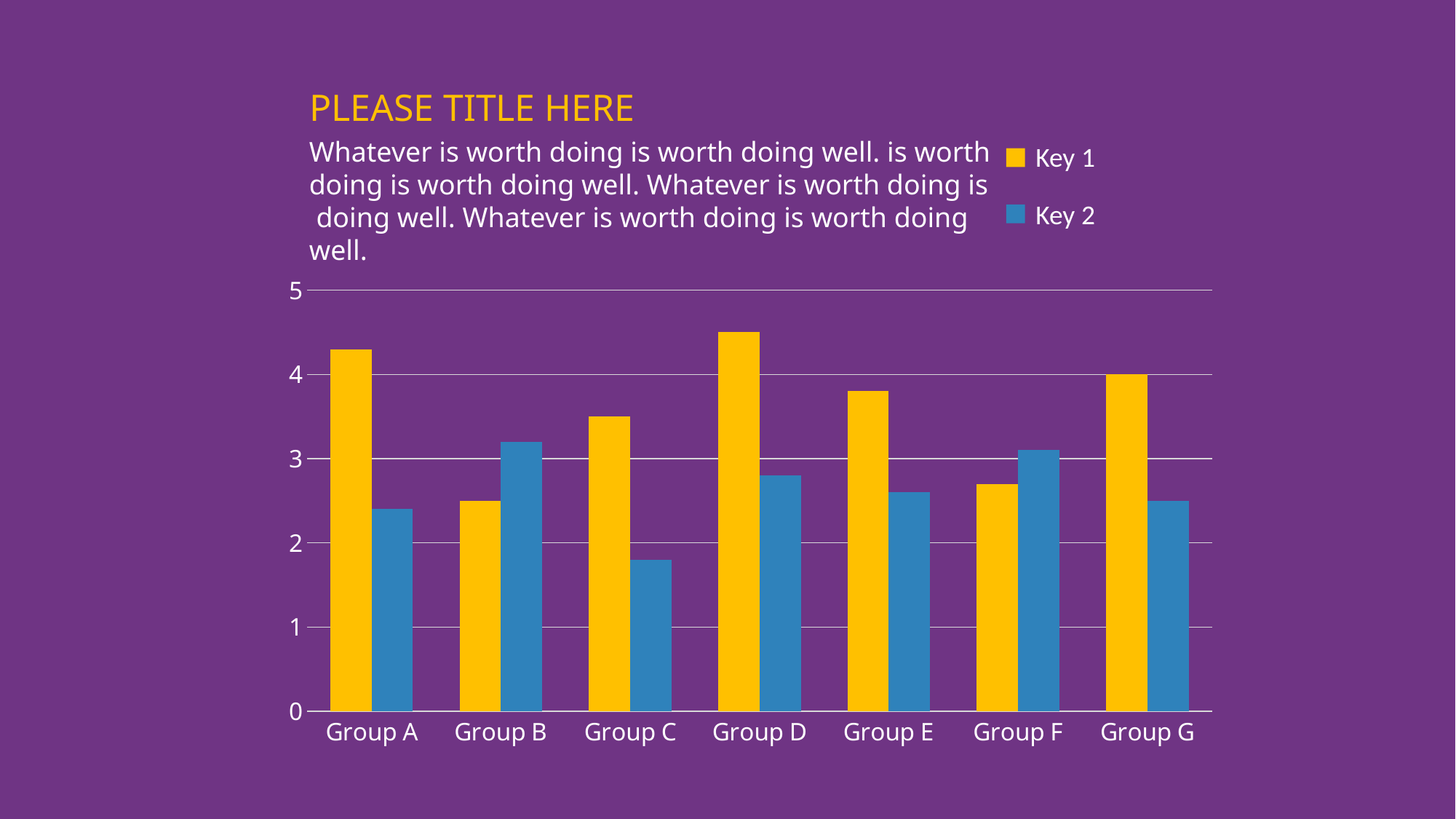
Is the Key 1 value for Group F greater or less than 3? less What colour represents Key 1 in the chart's legend? yellow For Group B, which series has the larger value, Key 1 or Key 2? Key 2 Is the Key 2 value for Group C greater or less than 2? less Which group has the highest Key 1 value? Group D How many series does the chart's legend list? 2 What kind of chart is shown on the slide? bar chart Is the Key 2 value for Group D greater or less than 3? less For Group C, which series has the larger value, Key 1 or Key 2? Key 1 Which group has the lowest Key 2 value? Group C How many groups are shown on the x axis of the chart? 7